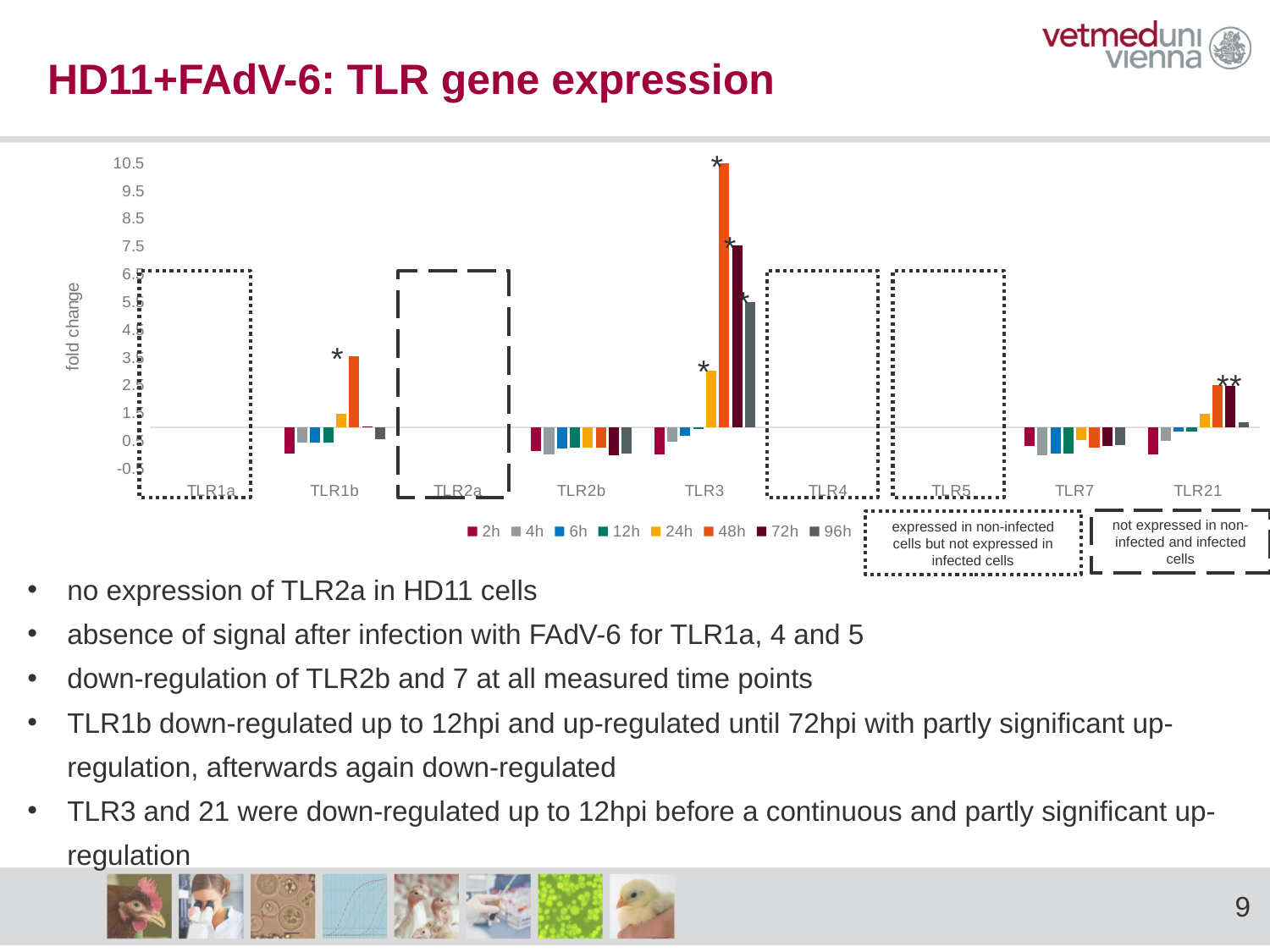
Is the 48h fold change for TLR1b greater or less than 2.5? greater Is the 72h fold change for TLR3 greater or less than 6.5? greater Which TLR category contains the tallest bar in the chart? TLR3 What is the label of the y axis of the chart? fold change How many series (time points) does the chart legend list? 8 Within the TLR3 group, which time point has the highest fold change? 48h Which is larger, the 48h fold change for TLR1b or the 48h fold change for TLR21? TLR1b Is the 24h fold change for TLR3 greater or less than 1.5? greater How many TLR categories are labelled along the x axis of the chart? 9 What kind of chart is shown on the slide? bar chart Which is larger for TLR3, the 48h bar or the 72h bar? 48h